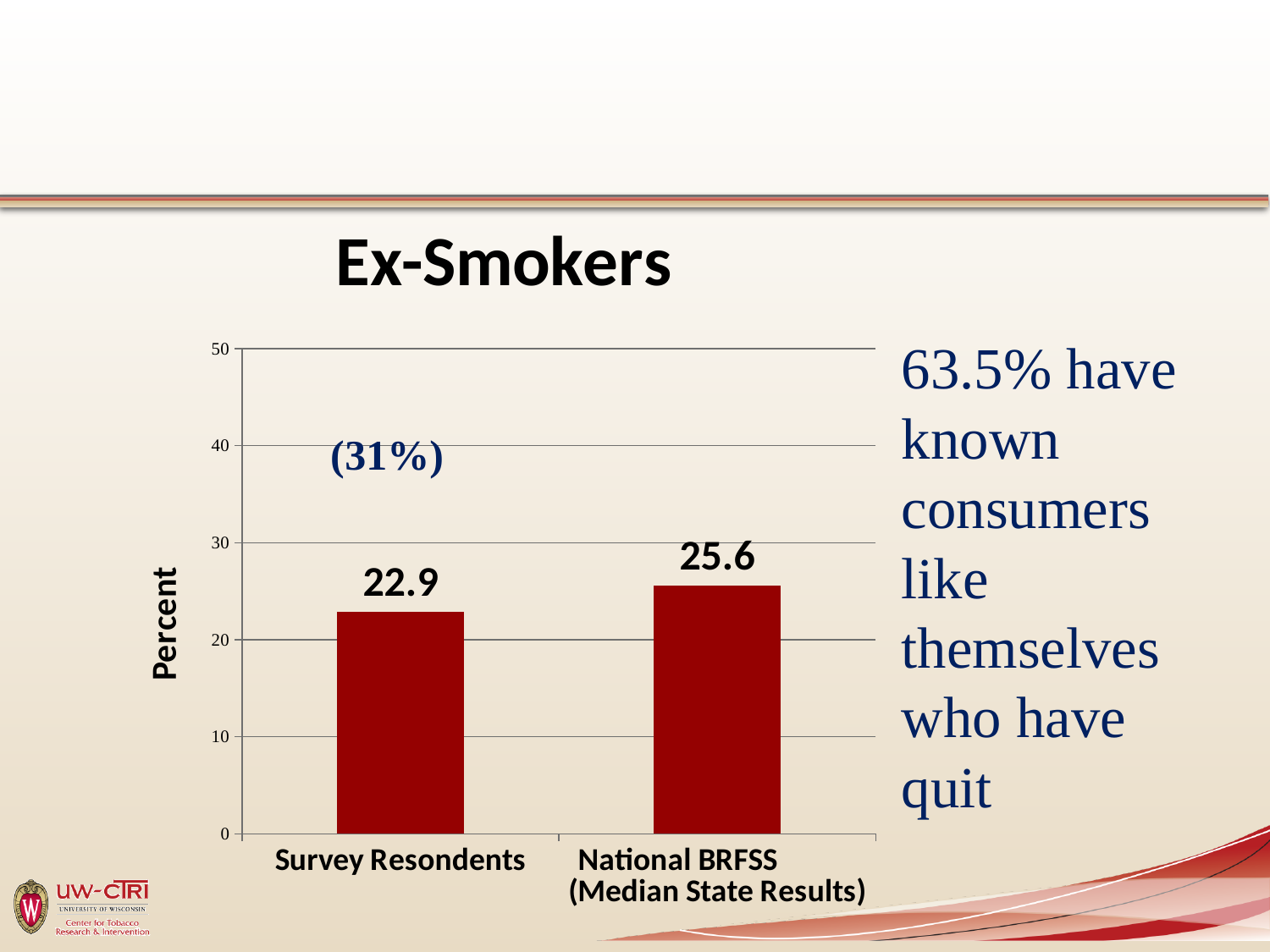
What is the difference between the National BRFSS (Median State Results) value and the Survey Resondents value? 2.7 How many categories are shown on the x axis? 2 Which is larger, the value for Survey Resondents or the value for National BRFSS (Median State Results)? National BRFSS (Median State Results) Is the value for National BRFSS (Median State Results) greater or less than 20? greater What is the title of the chart? Ex-Smokers Is the value for Survey Resondents greater or less than 30? less Which category has the highest value? National BRFSS (Median State Results) What is the value for National BRFSS (Median State Results)? 25.6 What is the label of the y axis? Percent What is the value for Survey Resondents? 22.9 What kind of chart is shown on the slide? bar chart Which category has the lowest value? Survey Resondents